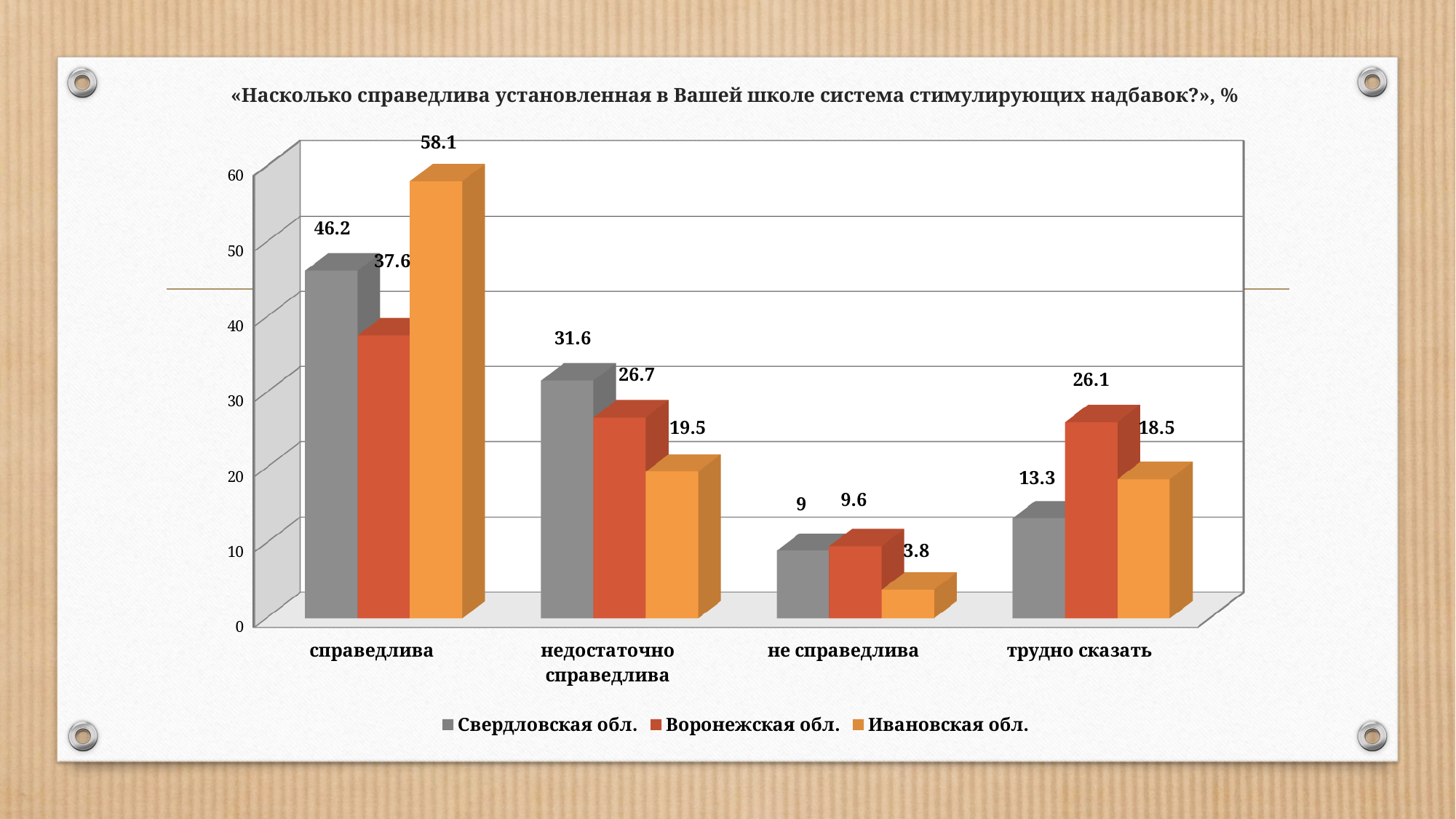
What is the value for Ивановская обл. in the category справедлива? 58.1 How many series does the legend list? 3 What is the difference between the values for Свердловская обл. and Воронежская обл. in the category справедлива? 8.6 What is the value for Ивановская обл. in the category не справедлива? 3.8 Which region has the lowest value in the category трудно сказать? Свердловская обл. What is the value for Воронежская обл. in the category трудно сказать? 26.1 Which is larger: the value for Воронежская обл. or Ивановская обл. in the category недостаточно справедлива? Воронежская обл. How many categories are shown on the x axis? 4 Which colour represents Ивановская обл. in the chart? Orange Which region has the highest value in the category справедлива? Ивановская обл. What kind of chart is shown on the slide? Bar chart What is the value for Свердловская обл. in the category недостаточно справедлива? 31.6